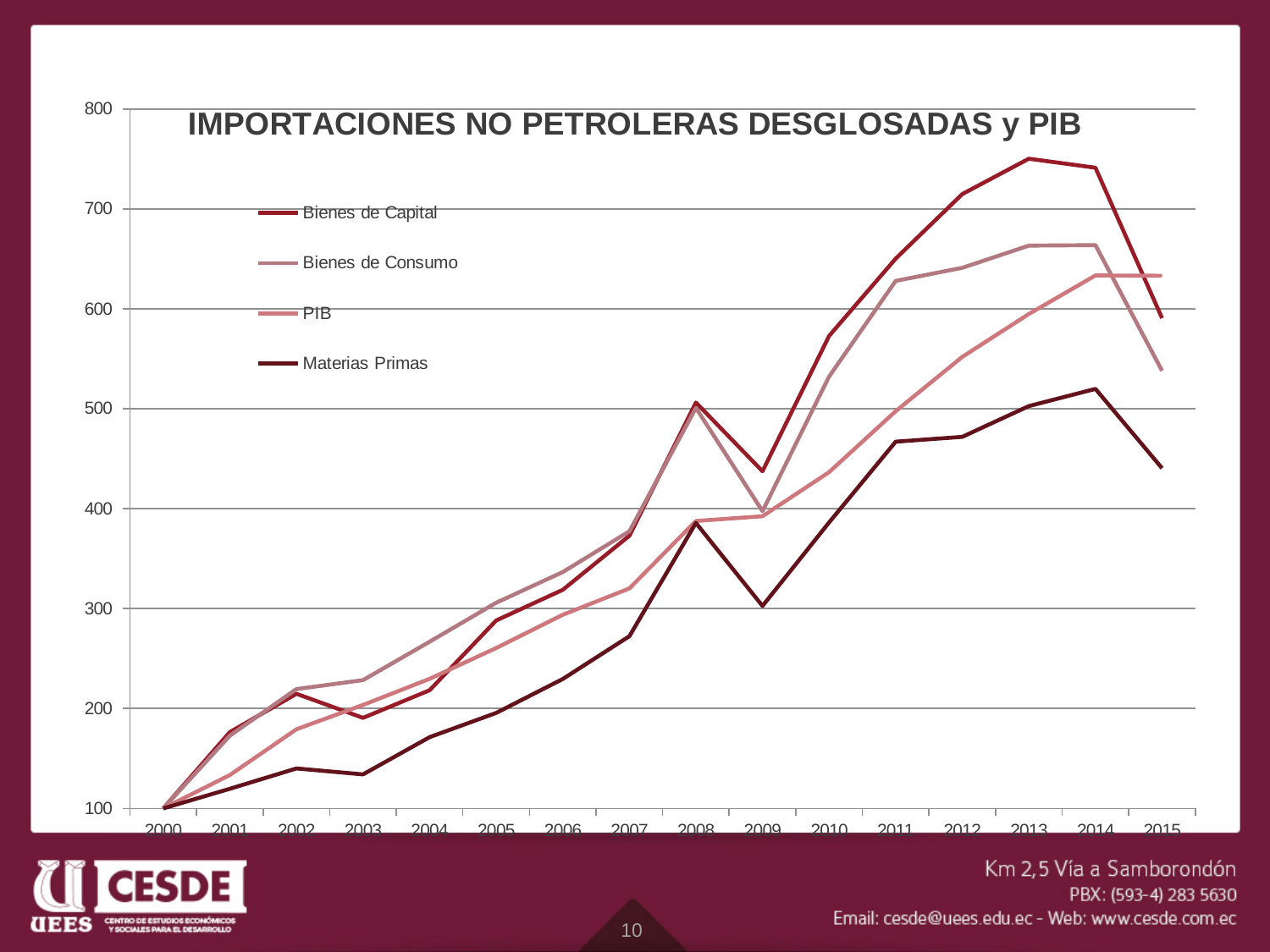
Which series has the highest value in 2013? Bienes de Capital What is the title of the chart? IMPORTACIONES NO PETROLERAS DESGLOSADAS y PIB Is the value for Materias Primas in 2009 greater or less than 400? less Does the Materias Primas line rise or fall from 2014 to 2015? Fall Is the value for Bienes de Capital in 2013 greater or less than 700? greater In 2015, which is larger: Bienes de Capital or Bienes de Consumo? Bienes de Capital Is the value for PIB in 2014 greater or less than 600? greater What kind of chart is shown on the slide? Line chart Which series has the lowest value in 2015? Materias Primas What is the value of Bienes de Capital in 2000? 100 How many series does the legend list? 4 How many years are shown on the x axis? 16